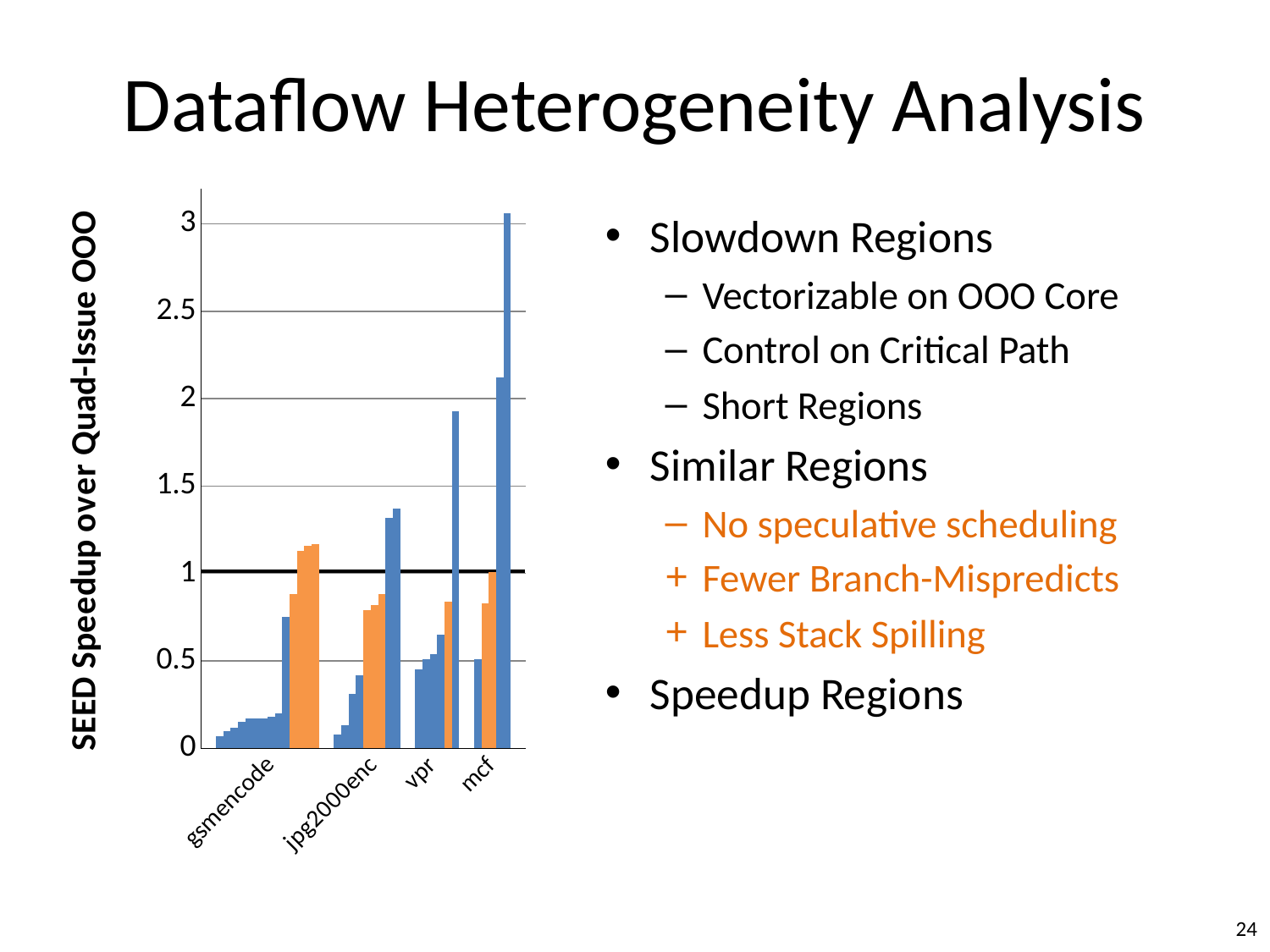
What is the title of the y axis of the chart? SEED Speedup over Quad-Issue OOO Which group has a taller maximum bar, gsmencode or mcf? mcf Is the tallest bar in the gsmencode group greater or less than 1.5? less What is the highest tick value shown on the y axis of the chart? 3 Is the tallest bar in the mcf group greater or less than 2.5? greater Which group has a taller maximum bar, vpr or jpg2000enc? vpr Is the tallest bar in the jpg2000enc group greater or less than 1.5? less What kind of chart is shown on the slide? bar chart How many benchmark labels are shown on the x axis of the chart? 4 Which benchmark group contains the tallest bar in the chart? mcf